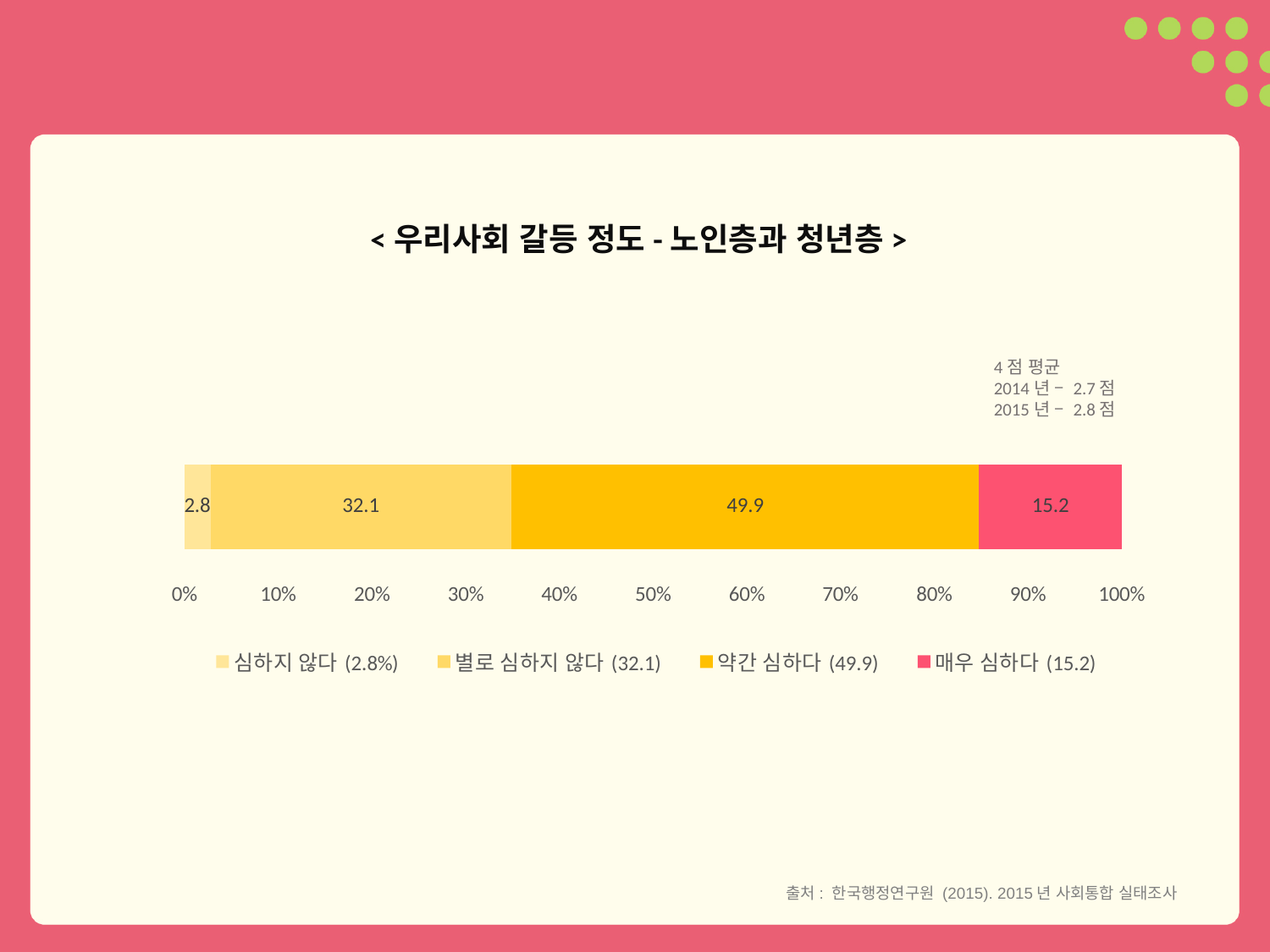
How many series does the legend list? 4 What type of chart is shown on the slide? stacked bar chart What is the total of all segments in the stacked bar? 100 What is the value for 약간 심하다? 49.9 What is the value for 매우 심하다? 15.2 What is the value for 심하지 않다? 2.8 What is the value for 별로 심하지 않다? 32.1 What is the difference between the values for 약간 심하다 and 별로 심하지 않다? 17.8 Which is larger, the value for 매우 심하다 or the value for 별로 심하지 않다? 별로 심하지 않다 Which response category has the smallest value? 심하지 않다 What is the title of the chart? < 우리사회 갈등 정도 - 노인층과 청년층 > Which response category has the largest value? 약간 심하다